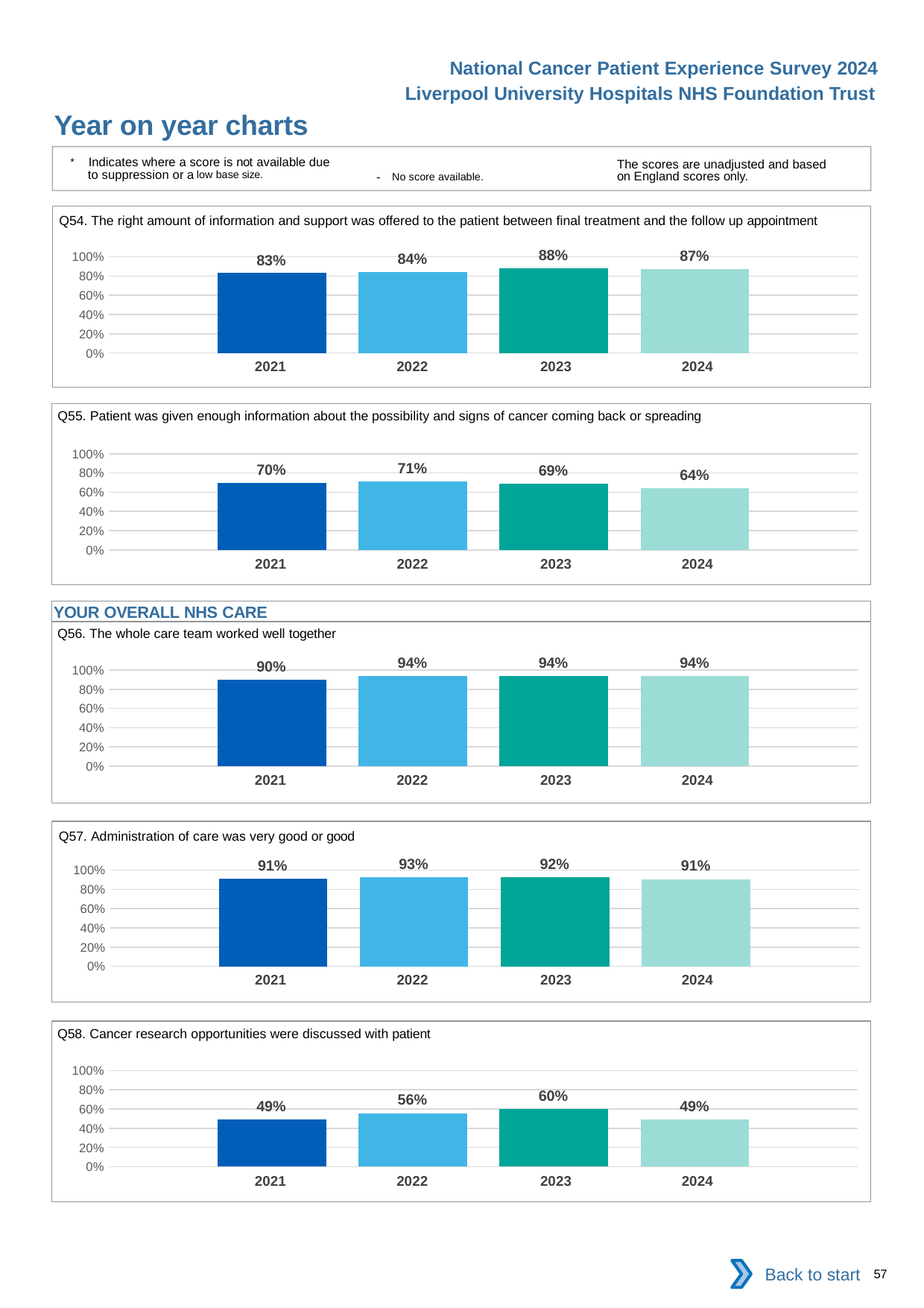
In the Q56 chart, what is the value for 2021? 90% In the Q55 chart, which year has the lowest value? 2024 In the Q54 chart, what is the value for 2023? 88% In the Q57 chart, which year has the highest value? 2022 In the Q54 chart, what is the value for 2021? 83% In the Q55 chart, is the value for 2024 greater or less than 80%? less In the Q58 chart, is the value for 2022 larger than the value for 2024? Yes How many bars are plotted in the Q54 chart? 4 In the Q58 chart, what is the difference between the 2023 and 2021 values? 11% What type of chart is the Q57 chart? Bar chart In the Q55 chart, what is the difference between the 2022 and 2024 values? 7% In the Q58 chart, which year has the highest value? 2023